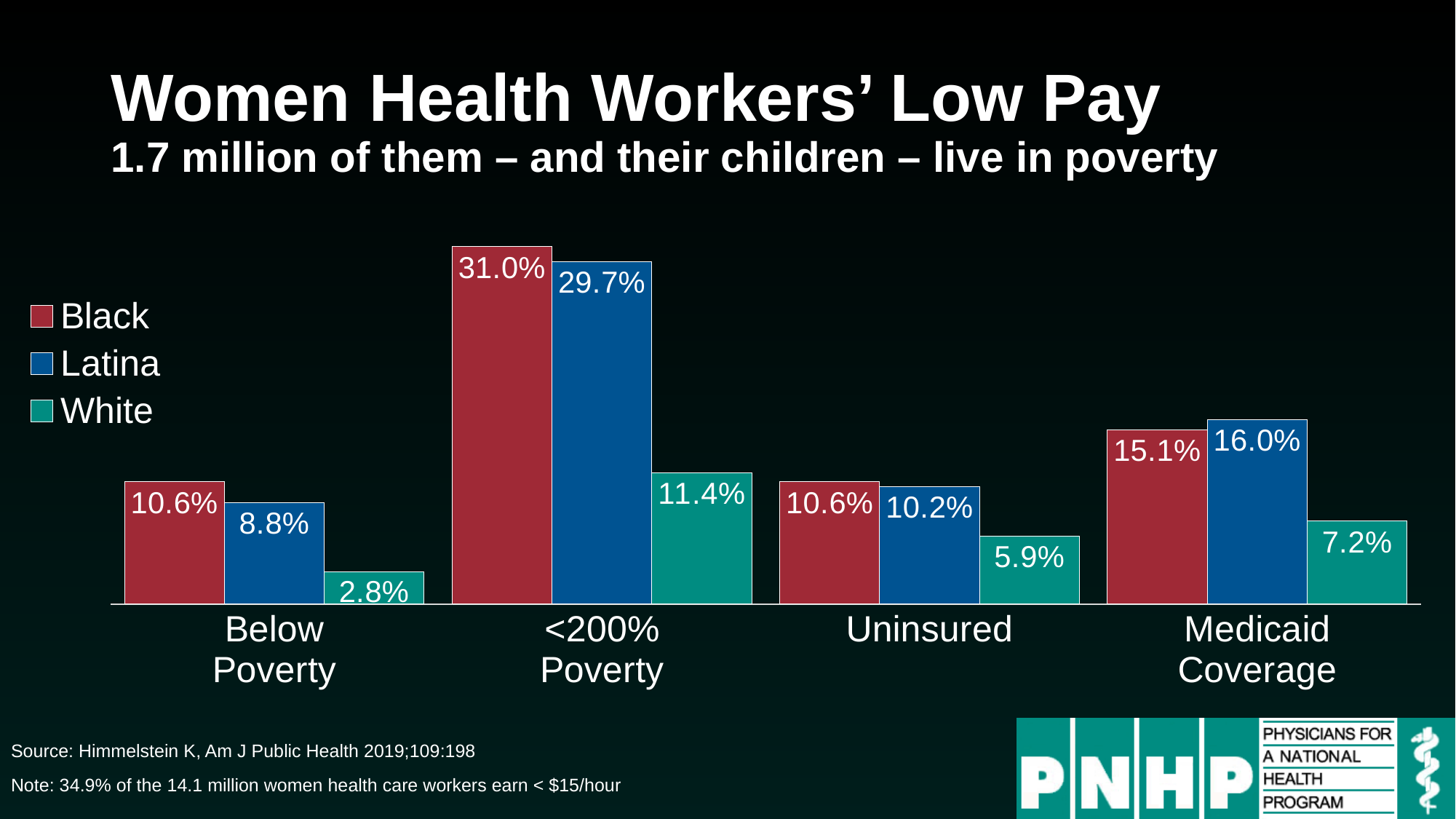
What is the value for Latina in the Medicaid Coverage category? 16.0% What kind of chart is shown on the slide? Bar chart Which colour represents the Latina series in the legend? Blue What is the value for White in the Uninsured category? 5.9% What is the value for Black in the Below Poverty category? 10.6% How many series does the legend list? 3 Which category has the lowest value for the White series? Below Poverty What is the value for White in the <200% Poverty category? 11.4% How many categories are shown on the x axis? 4 What is the difference between the Black and Latina values in the <200% Poverty category? 1.3% In the Medicaid Coverage category, which is larger, the Black value or the Latina value? Latina Which category has the highest value for the Black series? <200% Poverty